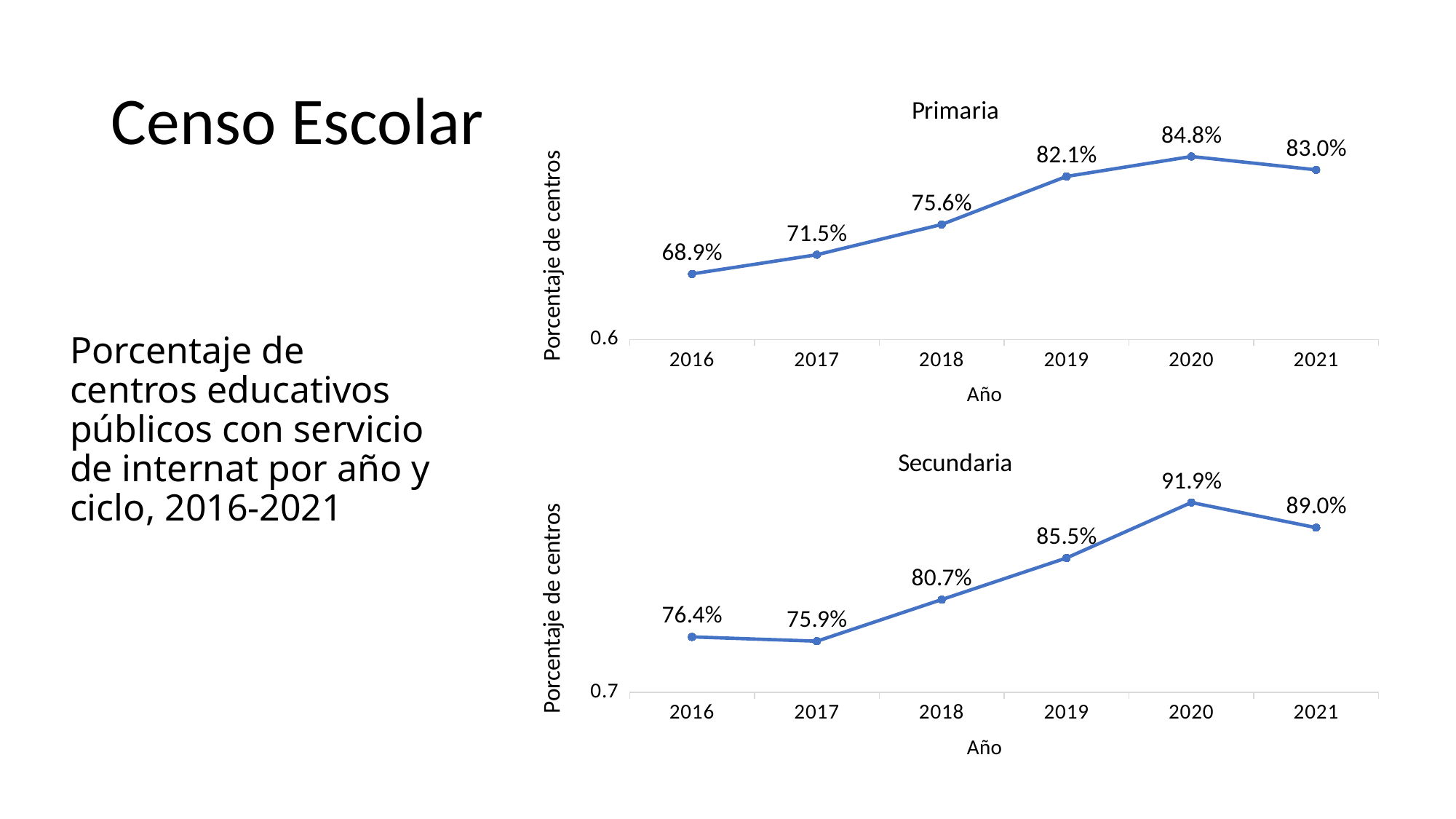
What is the x-axis title of the Secundaria chart? Año In the Secundaria chart, which year has the larger value, 2018 or 2021? 2021 In the Primaria chart, do the values rise or fall from 2016 to 2020? Rise What kind of chart is the Secundaria chart? Line chart In the Primaria chart, how many years are plotted? 6 In the Secundaria chart, what is the difference between the 2020 and 2021 values? 2.9% In the Secundaria chart, which year has the lowest value? 2017 In the Primaria chart, what is the value for 2018? 75.6% What is the y-axis title of the Primaria chart? Porcentaje de centros In the Secundaria chart, what is the value for 2019? 85.5% In the Primaria chart, what is the difference between the 2020 and 2016 values? 15.9% In the Primaria chart, which year has the highest value? 2020